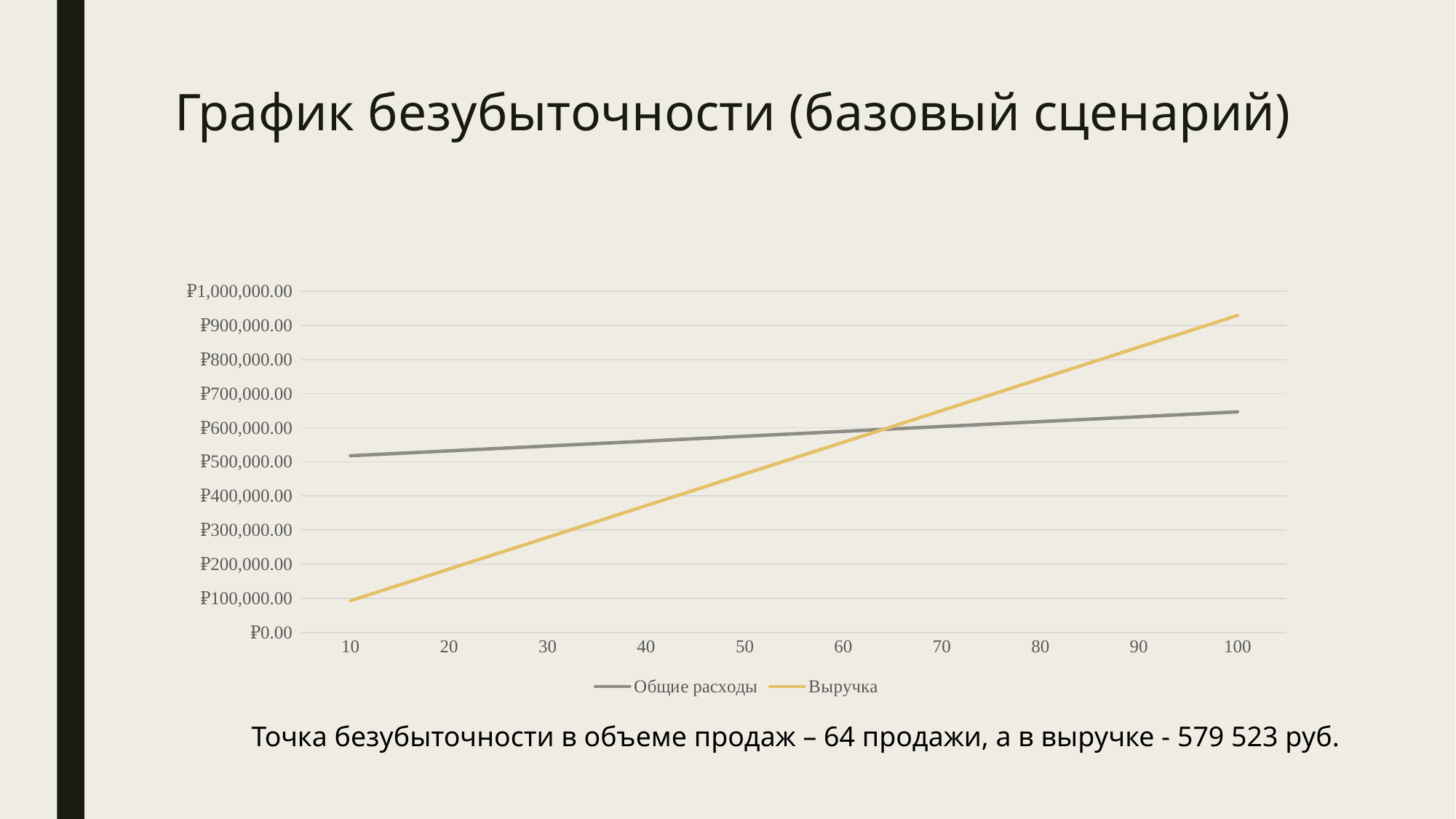
Is the value of Выручка at x = 50 greater or less than ₽500,000.00? less What kind of chart is shown on the slide? line chart How many series does the legend list? 2 Is the value of Выручка at x = 100 greater or less than ₽900,000.00? greater Is the value of Общие расходы at x = 10 greater or less than ₽500,000.00? greater At x = 10, which series has the larger value, Общие расходы or Выручка? Общие расходы At x = 100, which series has the larger value, Общие расходы or Выручка? Выручка Does the Выручка line rise or fall as the x-axis value increases from 10 to 100? rise How many x-axis points are plotted for each series? 10 What are the two series named in the legend? Общие расходы and Выручка What is the title of the chart slide? График безубыточности (базовый сценарий)